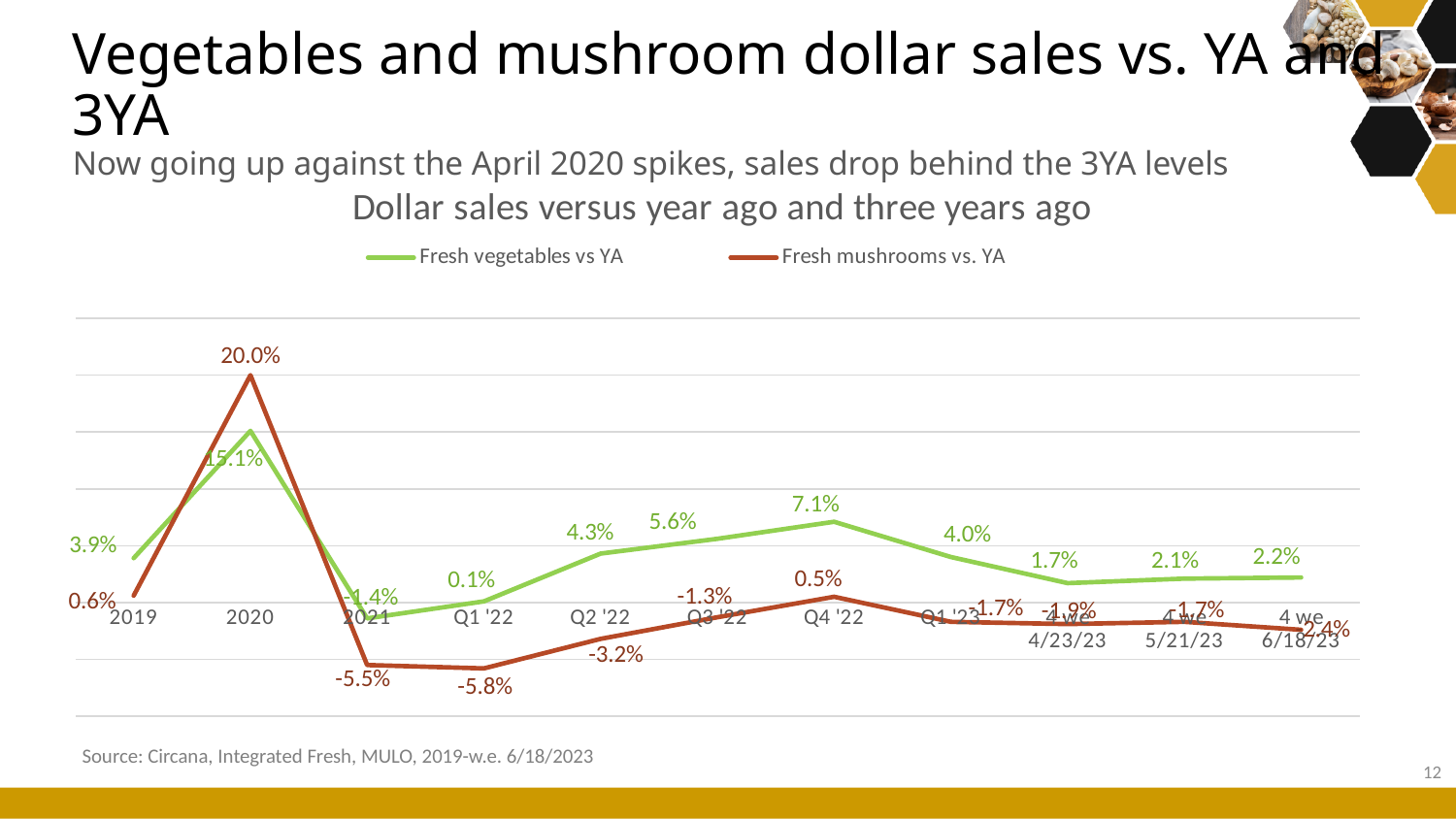
In which period is Fresh mushrooms vs. YA highest? 2020 In which period is Fresh vegetables vs YA highest? 2020 What is the value for Fresh mushrooms vs. YA in 2020? 20.0% In which period is Fresh mushrooms vs. YA lowest? Q1 '22 How many series does the legend list? 2 What is the value for Fresh vegetables vs YA in Q4 '22? 7.1% What is the value for Fresh mushrooms vs. YA in Q1 '22? -5.8% How many time periods are plotted along the x axis? 11 What kind of chart is shown on the slide? Line chart What is the value for Fresh vegetables vs YA in 2021? -1.4% In Q2 '22, which series has the larger value, Fresh vegetables vs YA or Fresh mushrooms vs. YA? Fresh vegetables vs YA In 2020, how much higher is Fresh mushrooms vs. YA than Fresh vegetables vs YA? 4.9 percentage points